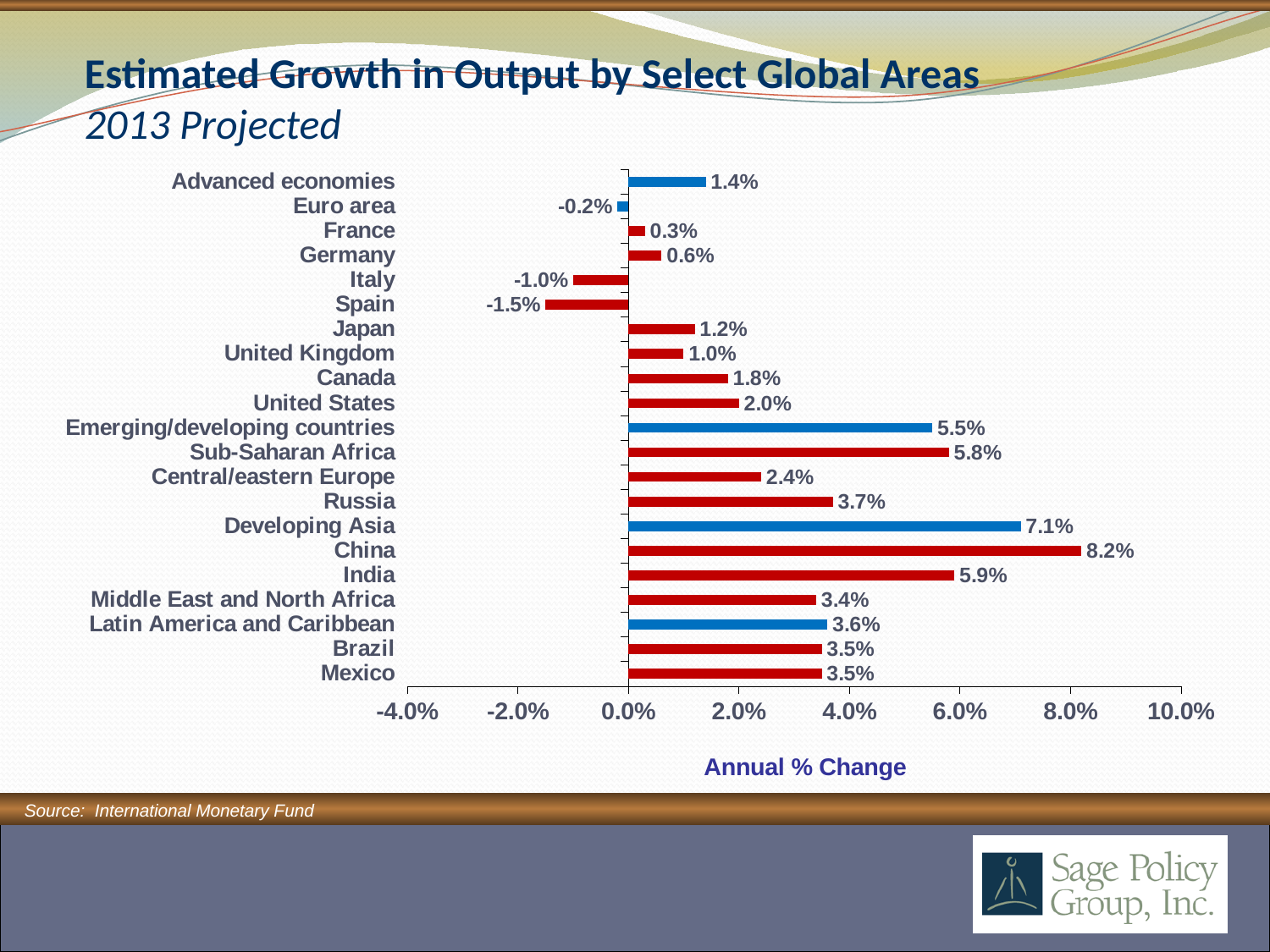
What kind of chart is shown on the slide? Bar chart What is the difference between the projected growth for China and India? 2.3% What is the projected 2013 growth in output for China? 8.2% Is the projected growth for Russia greater or less than 2.0%? greater What is the projected 2013 growth in output for the United States? 2.0% Which area has the lowest projected growth in output for 2013? Spain What is the label on the horizontal axis of the chart? Annual % Change How many areas are shown in the chart? 21 Which has a higher projected growth in output, Developing Asia or Emerging/developing countries? Developing Asia What is the projected 2013 growth in output for Spain? -1.5% Which area has the highest projected growth in output for 2013? China What is the projected 2013 growth in output for Sub-Saharan Africa? 5.8%